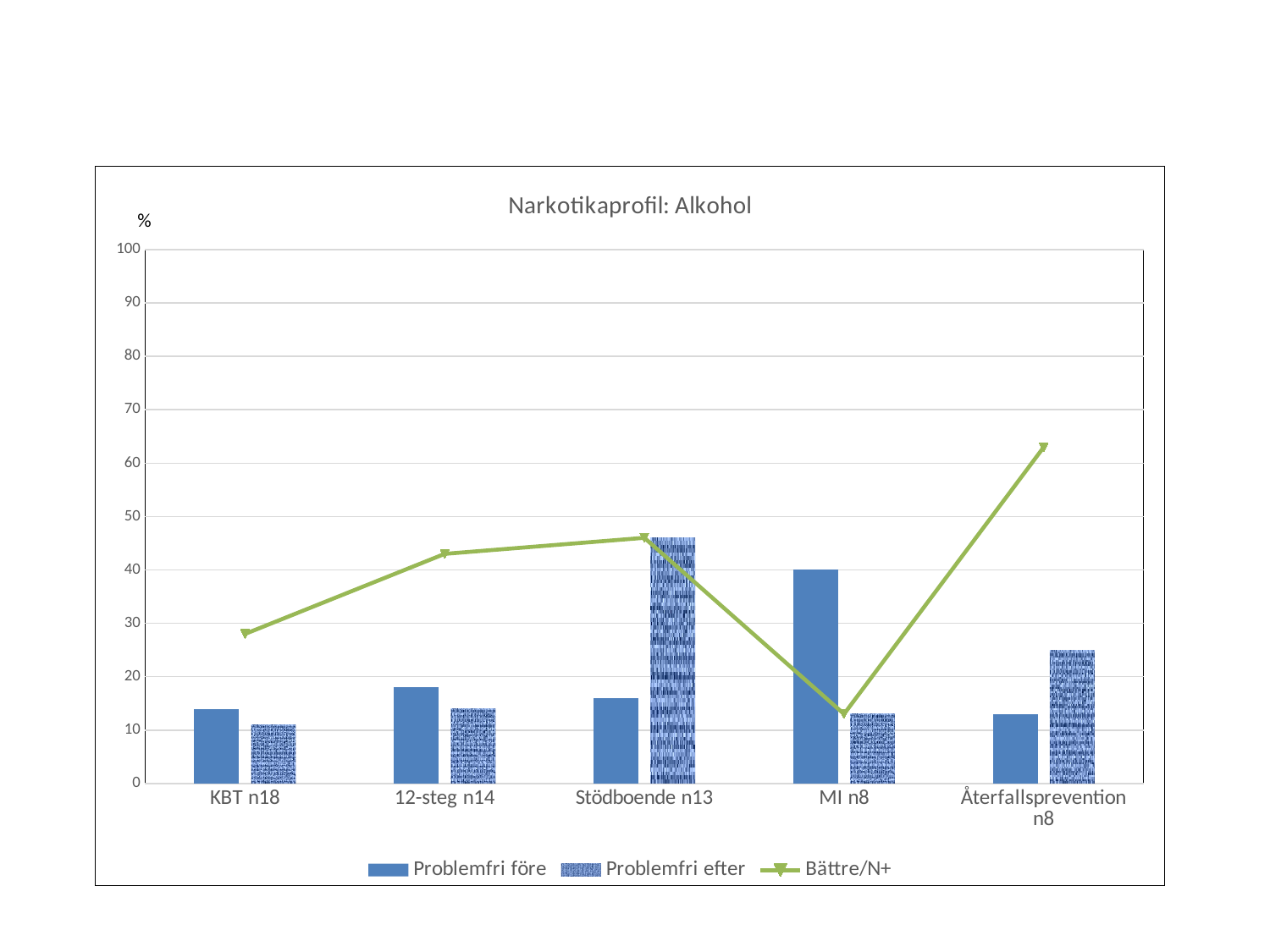
Which category has the highest value for Bättre/N+? Återfallsprevention n8 What kind of chart is shown on the slide? A combined bar and line chart How many categories are shown on the x axis? 5 Which category has the highest value for Problemfri före? MI n8 Is the Problemfri före value for MI n8 greater or less than 30? greater For Stödboende n13, which is larger: Problemfri före or Problemfri efter? Problemfri efter Which category has the lowest value for Bättre/N+? MI n8 Is the Problemfri efter value for KBT n18 greater or less than 20? less Which category has the highest value for Problemfri efter? Stödboende n13 What is the title of the chart? Narkotikaprofil: Alkohol Is the Bättre/N+ value for Återfallsprevention n8 greater or less than 60? greater How many series does the legend list? 3